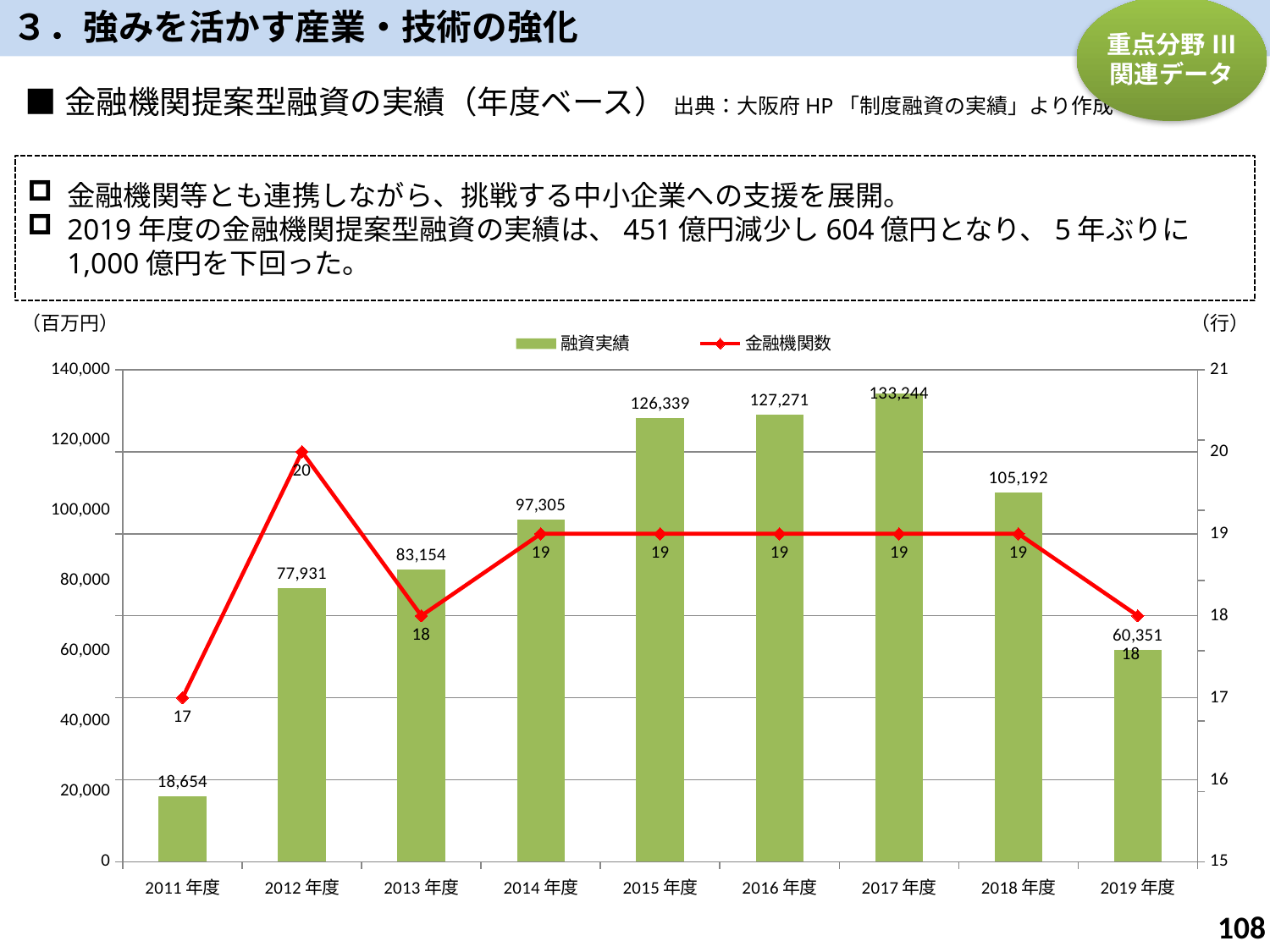
What kind of chart is used for the 融資実績 series? bar chart What is the difference in 融資実績 between 2018年度 and 2019年度? 44,841 What is the 金融機関数 value for 2019年度? 18 Which year has the highest 融資実績? 2017年度 How many series does the legend list? 2 Which is larger, the 融資実績 for 2014年度 or for 2013年度? 2014年度 How many years are shown on the x axis? 9 What is the 融資実績 value for 2017年度? 133,244 What is the 金融機関数 value for 2012年度? 20 Which year has the lowest 融資実績? 2011年度 What is the 融資実績 value for 2011年度? 18,654 Does the 融資実績 rise or fall from 2017年度 to 2019年度? fall